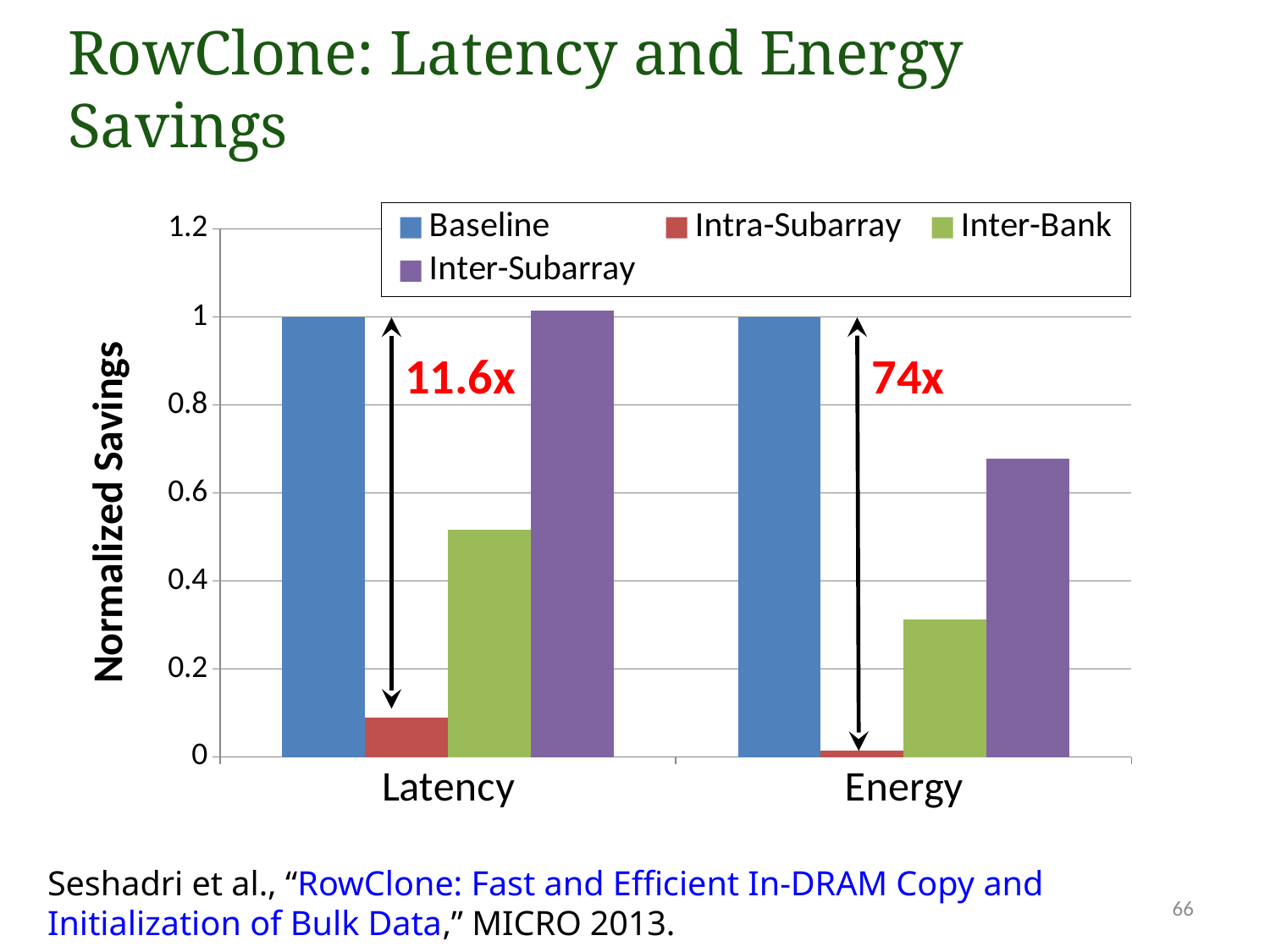
What speedup factor is annotated above the Latency bars? 11.6x What kind of chart is shown on the slide? bar chart Is the Inter-Bank value for Latency greater or less than 0.4? greater Which series has the lowest value for Energy? Intra-Subarray How many series does the legend list? 4 How many categories are shown on the x axis? 2 Is the Intra-Subarray value for Energy greater or less than 0.2? less What is the label of the y axis? Normalized Savings What is the Baseline value for Energy? 1 Is the Inter-Subarray value for Energy greater or less than 0.6? greater Which is larger for Latency, the Inter-Bank value or the Inter-Subarray value? Inter-Subarray What is the Baseline value for Latency? 1